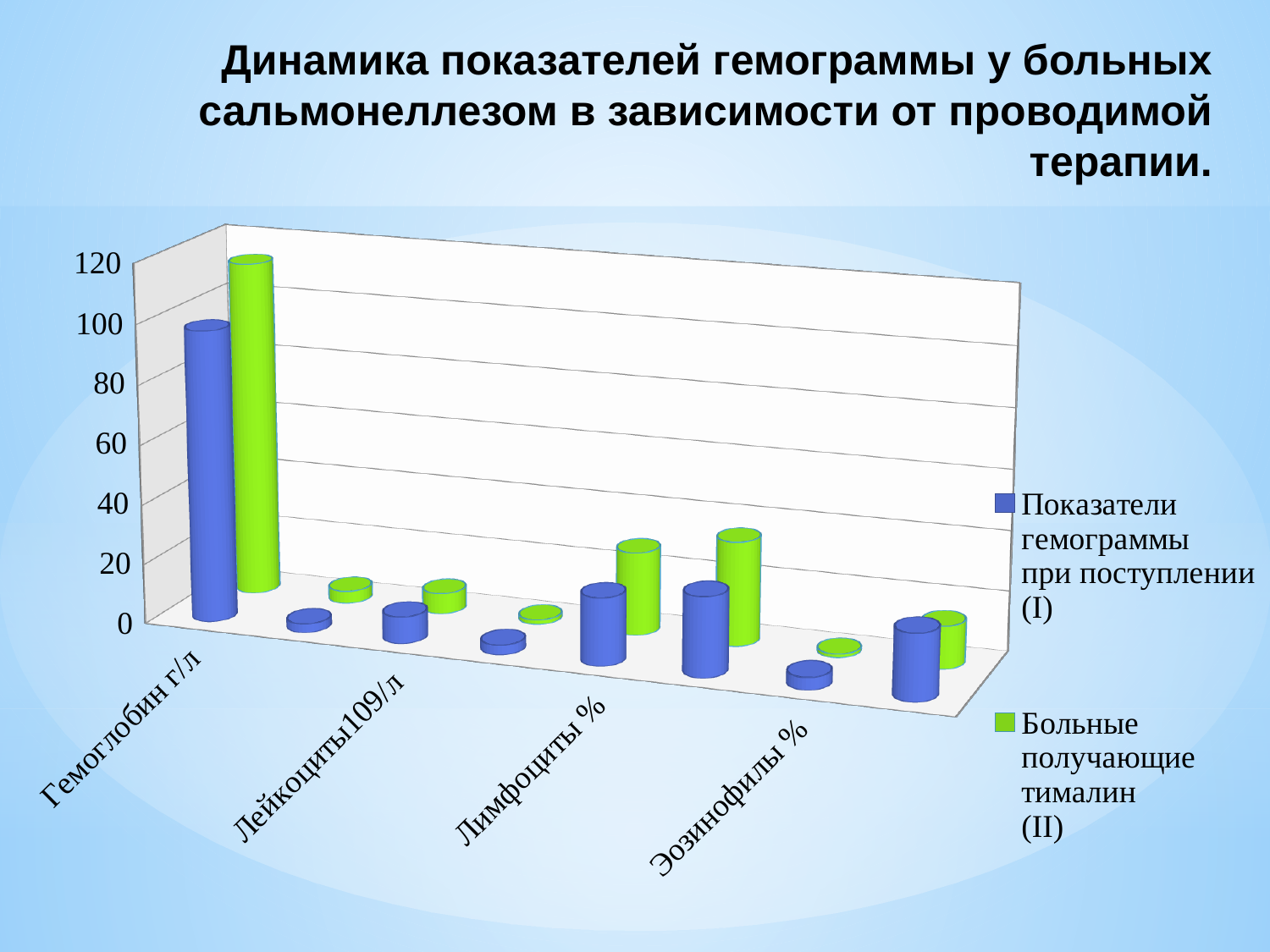
How many series does the legend list? 2 For Эозинофилы %, which series has the larger value: series (I) or series (II)? Показатели гемограммы при поступлении (I) Is the value for Лимфоциты % in the series Больные получающие тималин (II) greater or less than 40? less Is the value for Гемоглобин г/л in the series Больные получающие тималин (II) greater or less than 100? greater What kind of chart is shown on the slide? bar chart For Гемоглобин г/л, which series has the larger value: Показатели гемограммы при поступлении (I) or Больные получающие тималин (II)? Больные получающие тималин (II) Is the value for Лейкоциты109/л in the series Показатели гемограммы при поступлении (I) greater or less than 20? less Which category has the highest bar in the chart? Гемоглобин г/л What is the maximum value shown on the vertical axis? 120 What colour represents the series Больные получающие тималин (II)? green For Лимфоциты %, which series has the larger value: series (I) or series (II)? Больные получающие тималин (II)